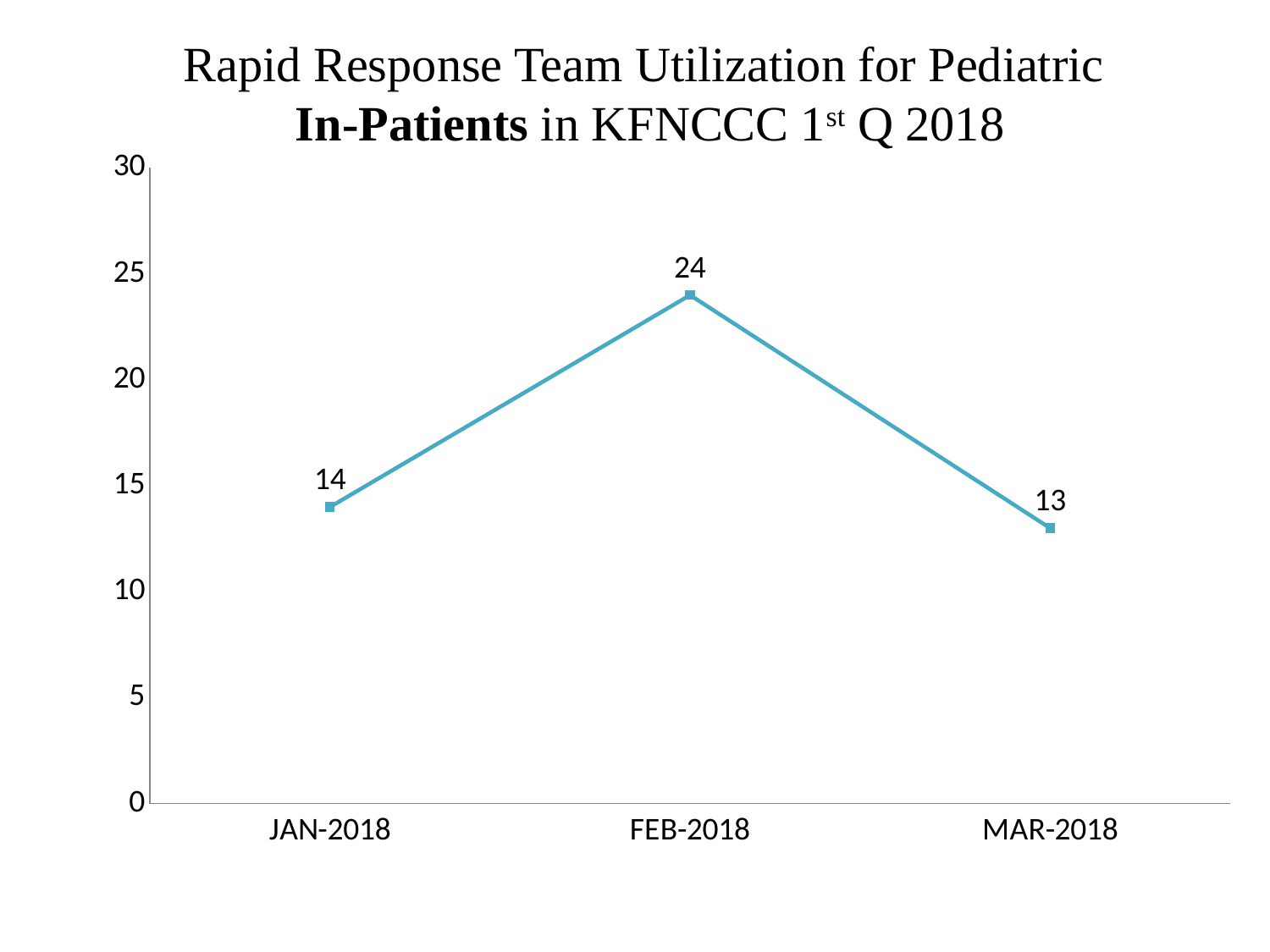
What is the difference between the values for FEB-2018 and MAR-2018? 11 Which month has the highest value? FEB-2018 What is the difference between the values for FEB-2018 and JAN-2018? 10 Does the value rise or fall from FEB-2018 to MAR-2018? fall What kind of chart is shown on the slide? line chart Is the value for FEB-2018 greater or less than 20? greater What is the value for FEB-2018? 24 What is the value for JAN-2018? 14 How many months are plotted on the chart? 3 Which is larger, the value for JAN-2018 or the value for MAR-2018? JAN-2018 Which month has the lowest value? MAR-2018 What is the value for MAR-2018? 13